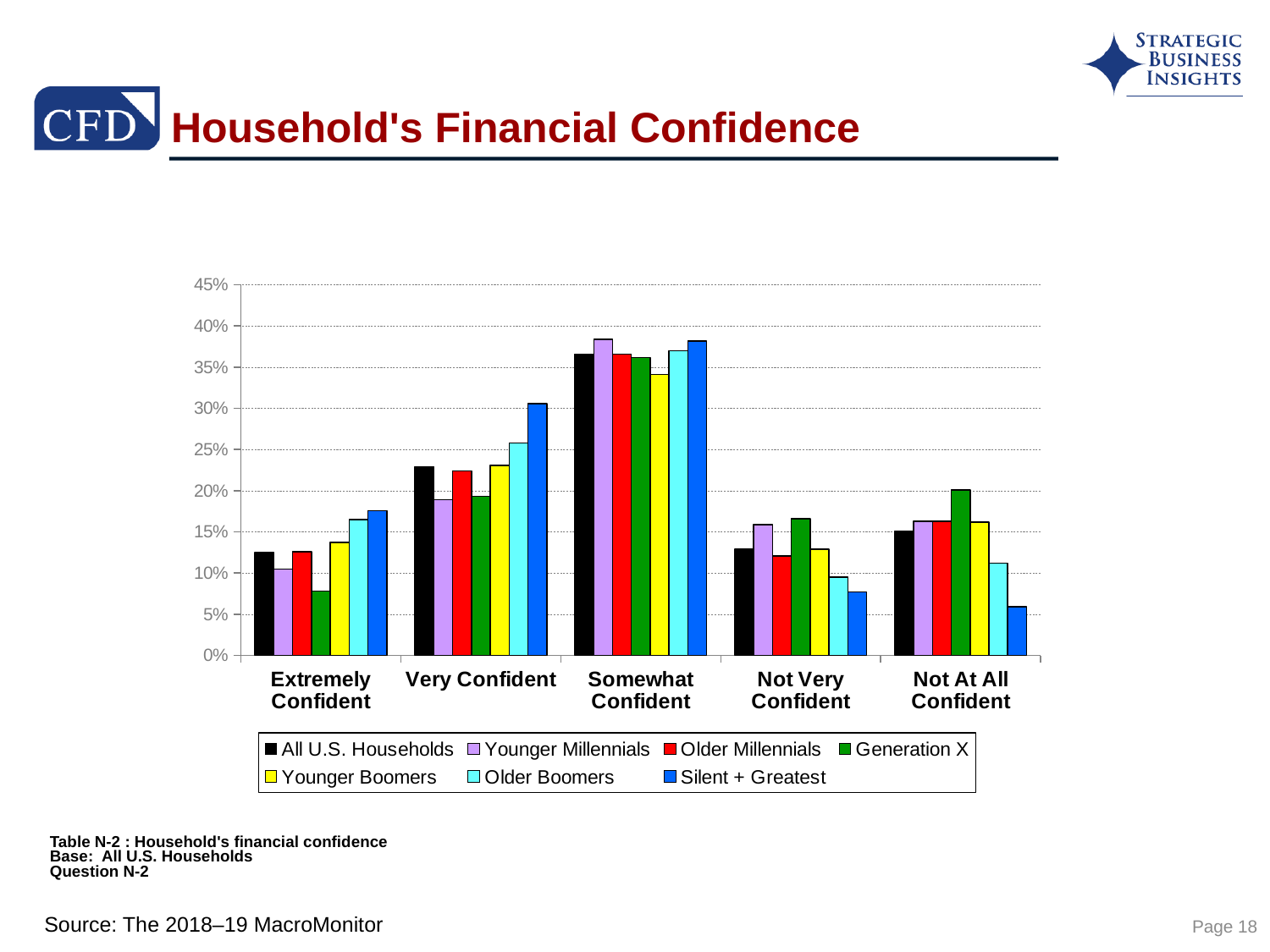
In the Not Very Confident category, which is larger: Generation X or Older Boomers? Generation X What is the title of the slide? Household's Financial Confidence Is the value for Silent + Greatest in the Very Confident category greater or less than 25%? greater In the Not At All Confident category, which series has the highest bar? Generation X Is the value for Generation X in the Extremely Confident category greater or less than 10%? less What kind of chart is shown on the slide? bar chart In the Not At All Confident category, which series has the lowest bar? Silent + Greatest In the Extremely Confident category, which series has the lowest bar? Generation X In the Very Confident category, which series has the highest bar? Silent + Greatest Which confidence category has the tallest bars overall? Somewhat Confident How many confidence categories are shown along the x axis? 5 How many series does the legend list? 7